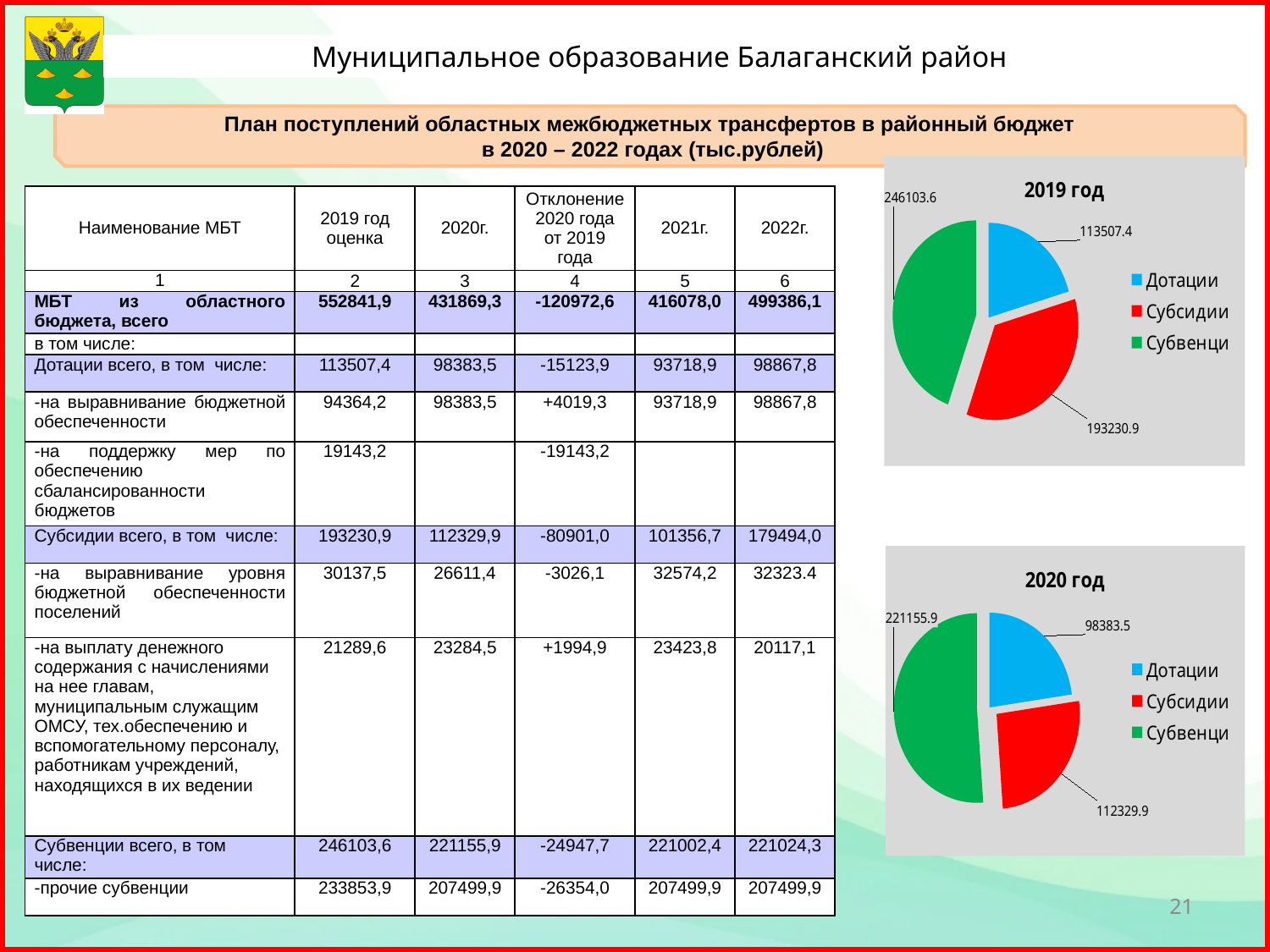
In the '2020 год' pie chart, which category has the largest slice? Субвенции In the '2019 год' pie chart, what is the difference between the values for Субвенции and Дотации? 132596.2 In the '2020 год' pie chart, which is larger: Субсидии or Дотации? Субсидии In the '2019 год' pie chart, which category has the smallest slice? Дотации What type of chart is used for '2019 год'? Pie chart In the '2020 год' pie chart, what is the value for Дотации? 98383.5 In the '2019 год' pie chart, what is the value for Субсидии? 193230.9 In the '2020 год' pie chart, what is the total of all three slices? 431869.3 How many slices does the '2020 год' pie chart have? 3 In the '2019 год' pie chart, which colour represents Субсидии? Red How many entries does the legend of the '2019 год' chart list? 3 In the '2019 год' pie chart, what is the value for Субвенции? 246103.6